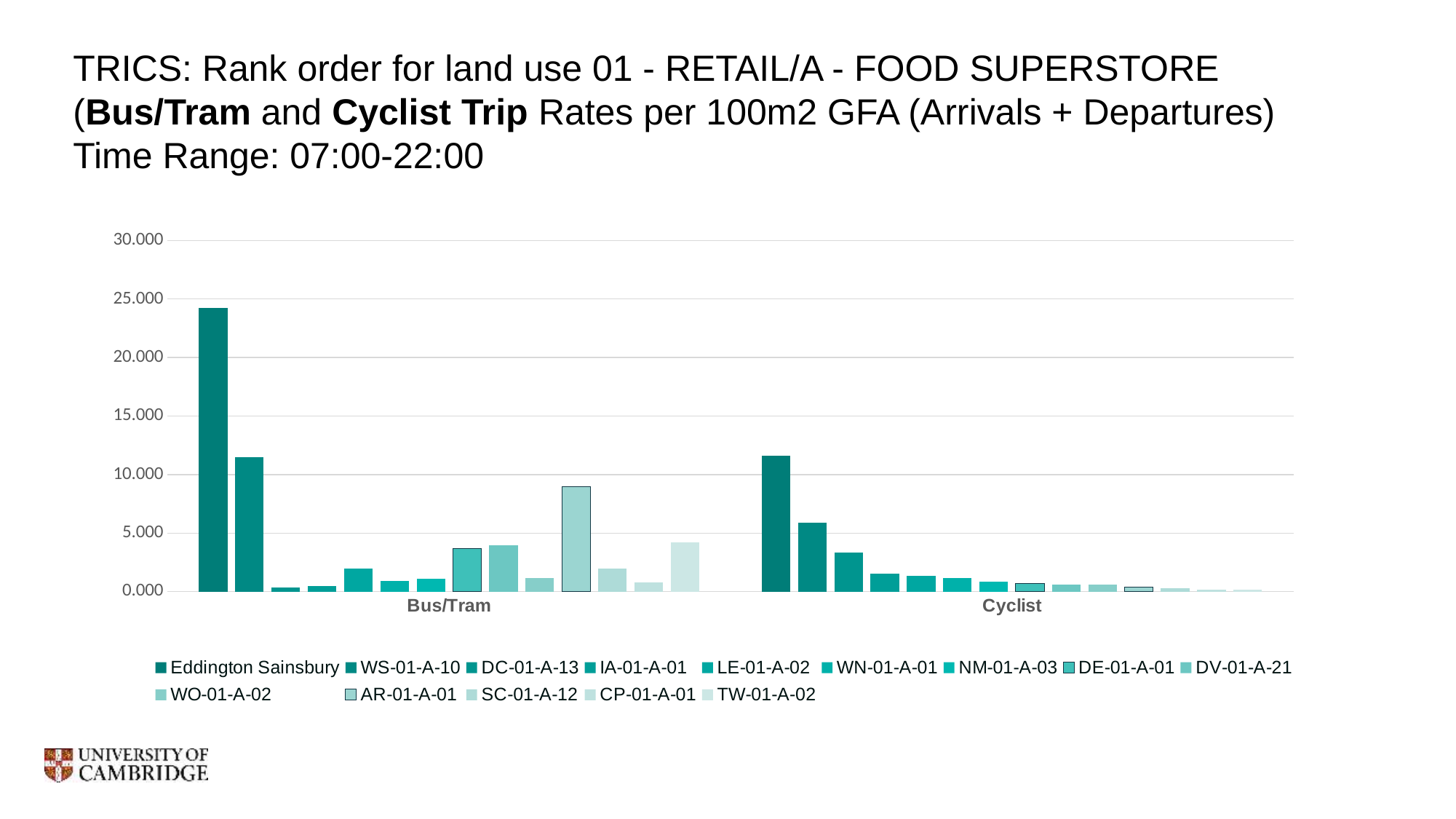
Is the Bus/Tram value for WS-01-A-10 greater or less than 10.000? greater Which series has the highest value in the Cyclist category? Eddington Sainsbury Which series has the highest value in the Bus/Tram category? Eddington Sainsbury What kind of chart is shown on the slide? bar chart In the Bus/Tram category, which is larger: the value for WS-01-A-10 or the value for AR-01-A-01? WS-01-A-10 Is the Cyclist value for Eddington Sainsbury greater or less than 10.000? greater Is the Bus/Tram value for AR-01-A-01 greater or less than 10.000? less How many categories are shown on the x axis of the chart? 2 What are the two category labels shown on the x axis of the chart? Bus/Tram and Cyclist How many series does the chart's legend list? 14 For Eddington Sainsbury, which is larger: the Bus/Tram value or the Cyclist value? Bus/Tram